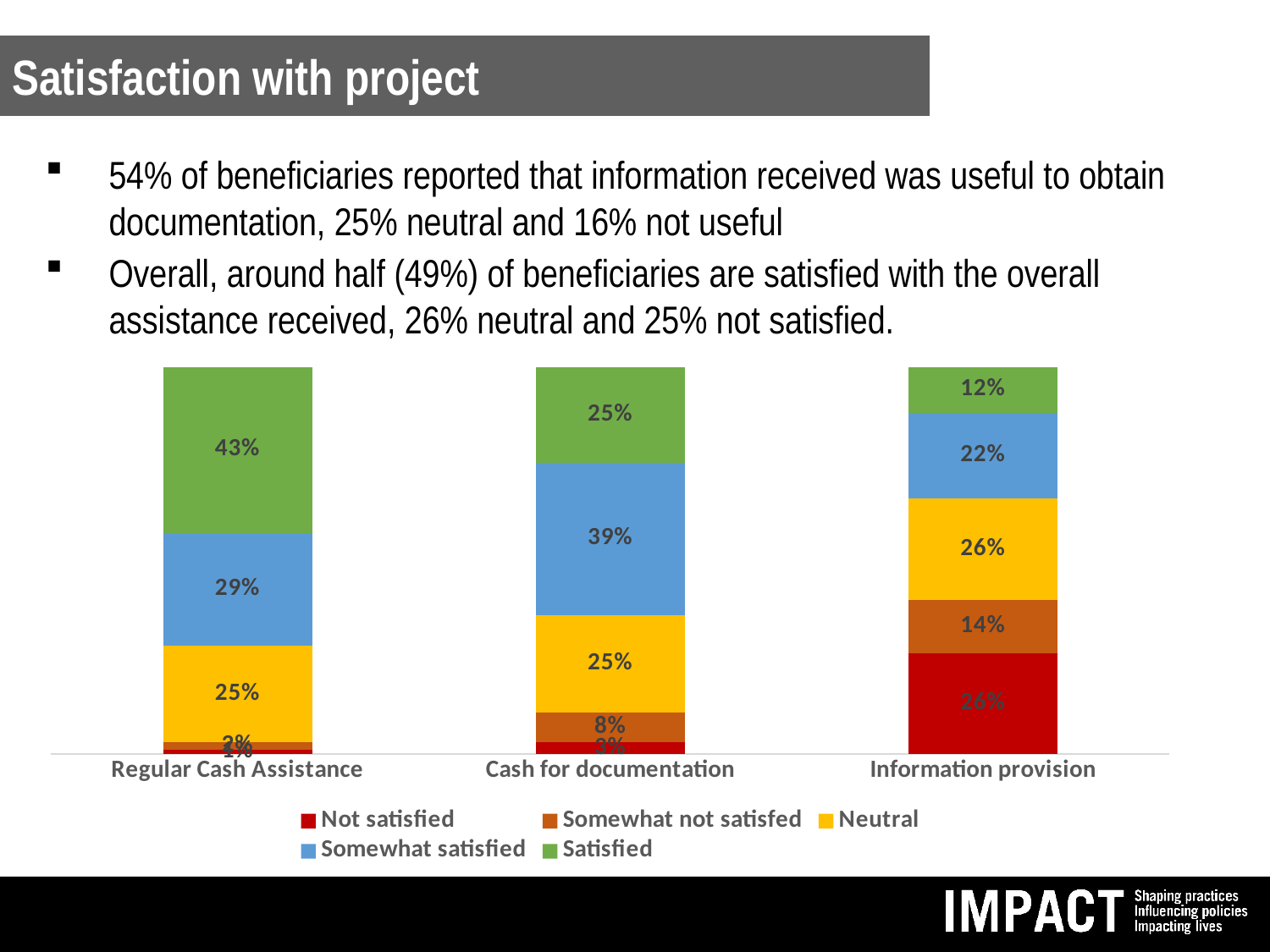
Which category has the highest Satisfied value? Regular Cash Assistance Which category has the lowest Satisfied value? Information provision Which legend entry is shown in red? Not satisfied What kind of chart is shown on the slide? Stacked bar chart What is the Not satisfied value for Information provision? 26% What is the difference between the Satisfied values for Regular Cash Assistance and Information provision? 31% What is the Somewhat satisfied value for Cash for documentation? 39% How many series does the chart's legend list? 5 What is the Satisfied value for Regular Cash Assistance? 43% Which is larger: the Somewhat satisfied value for Cash for documentation or for Information provision? Cash for documentation What is the Somewhat not satisfied value for Cash for documentation? 8% How many categories are shown on the x axis of the chart? 3